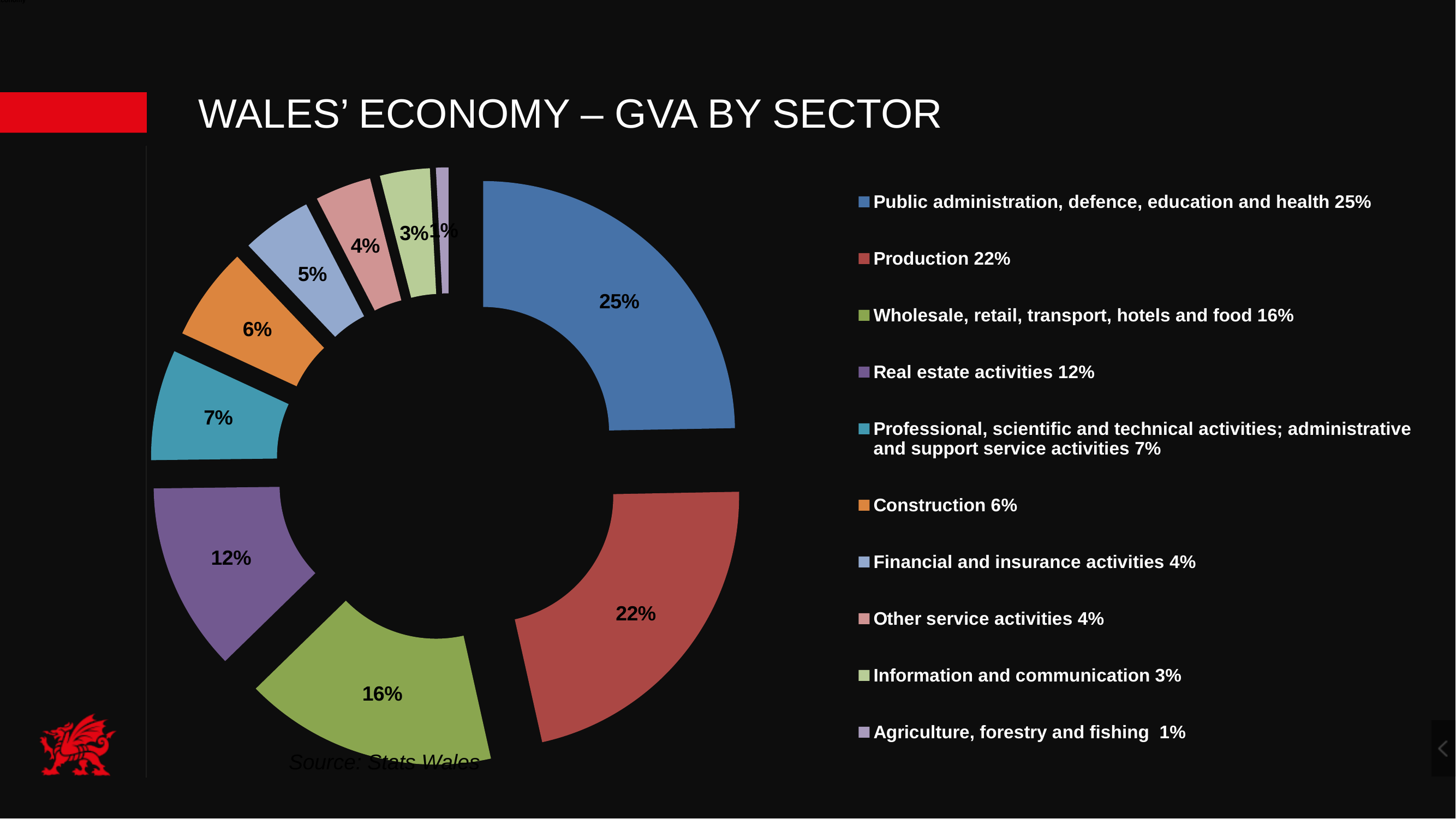
How many sectors are shown in the chart? 10 What share of GVA does Real estate activities account for? 12% What is the difference in GVA share between Production and Wholesale, retail, transport, hotels and food? 6% Which sector has the smallest share of GVA? Agriculture, forestry and fishing What share of GVA does Construction account for? 6% What share of GVA does Wholesale, retail, transport, hotels and food account for? 16% Which has a larger share of GVA: Real estate activities or Construction? Real estate activities Which sector has the largest share of GVA? Public administration, defence, education and health What share of GVA does Public administration, defence, education and health account for? 25% What kind of chart is shown on the slide? Doughnut (pie) chart What share of GVA does Production account for? 22% What is the title of the slide? WALES' ECONOMY – GVA BY SECTOR